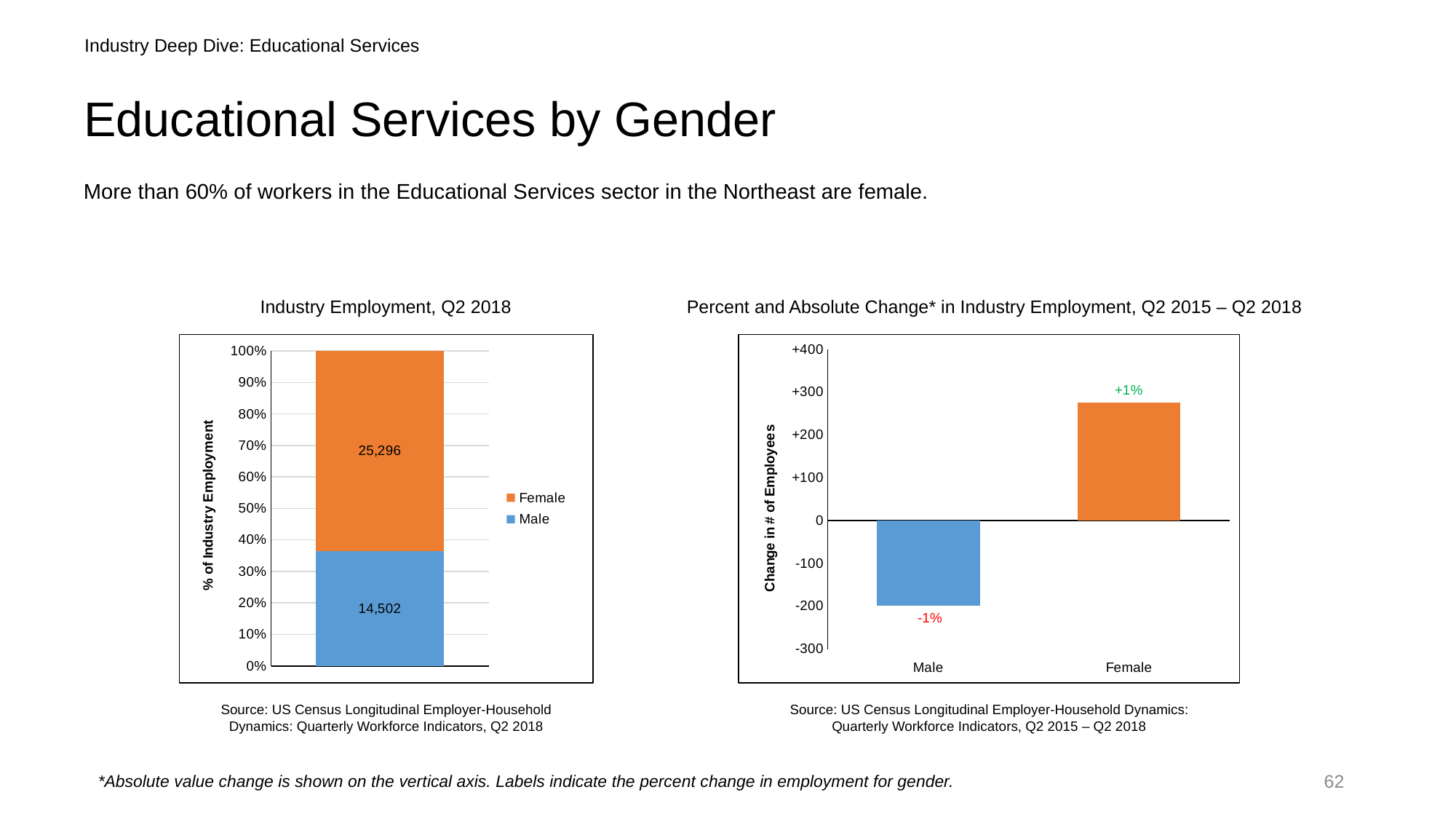
In the 'Percent and Absolute Change in Industry Employment, Q2 2015 – Q2 2018' chart, what percent change label is shown for Male? -1% In the 'Industry Employment, Q2 2018' chart, which is larger, Female or Male? Female In the 'Industry Employment, Q2 2018' chart, what is the total of the stacked bar? 39,798 In the 'Percent and Absolute Change in Industry Employment, Q2 2015 – Q2 2018' chart, what percent change label is shown for Female? +1% In the 'Industry Employment, Q2 2018' chart, what is the value for Male? 14,502 In the 'Percent and Absolute Change in Industry Employment, Q2 2015 – Q2 2018' chart, is the change in number of employees for Female greater or less than +200? greater In the 'Industry Employment, Q2 2018' chart, what is the value for Female? 25,296 In the 'Industry Employment, Q2 2018' chart, what is the vertical axis title? % of Industry Employment In the 'Industry Employment, Q2 2018' chart, how many series does the legend list? 2 In the 'Percent and Absolute Change in Industry Employment, Q2 2015 – Q2 2018' chart, is the change in number of employees for Male greater or less than -100? less What kind of chart is the 'Percent and Absolute Change in Industry Employment, Q2 2015 – Q2 2018' chart? Bar chart In the 'Industry Employment, Q2 2018' chart, what is the difference between the Female and Male values? 10,794